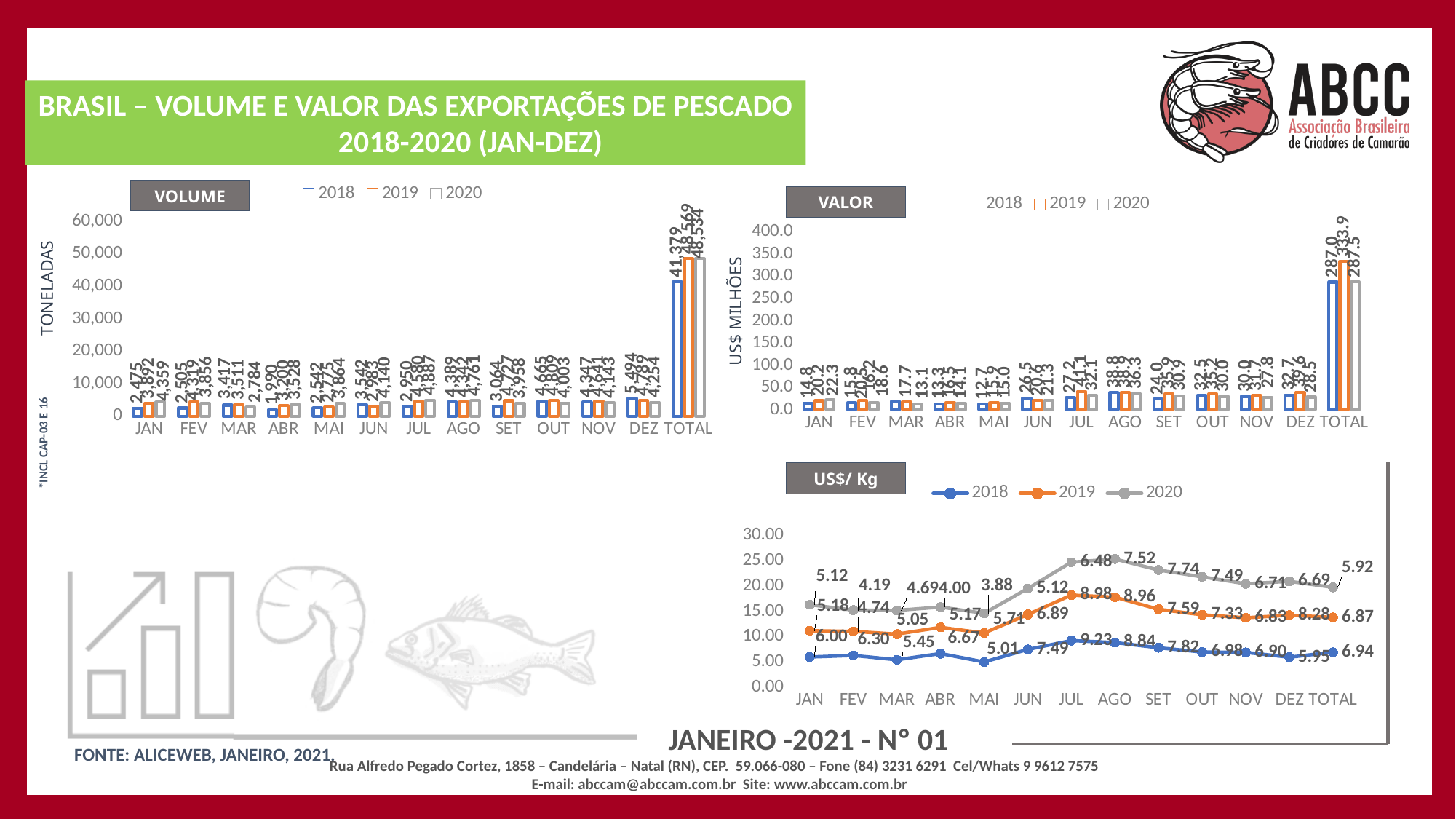
What kind of chart is the US$/Kg chart? line chart In the VALOR chart, what is the TOTAL value for 2019? 333.9 What kind of chart is the VOLUME chart? bar chart In the US$/Kg chart, how many categories are shown on the x axis? 13 In the VOLUME chart, what is the TOTAL value for 2019? 48,569 In the VALOR chart, which year has the highest TOTAL value? 2019 In the VOLUME chart, which is larger, the TOTAL for 2018 or the TOTAL for 2019? 2019 In the VALOR chart, what is the value for JUL in 2019? 41.1 How many series does the legend of the VOLUME chart list? 3 In the VOLUME chart, what is the value for DEZ in 2018? 5,494 In the VALOR chart, what is the difference between the TOTAL for 2019 and the TOTAL for 2018? 46.9 In the VOLUME chart, what is the difference between the TOTAL for 2019 and the TOTAL for 2020? 35